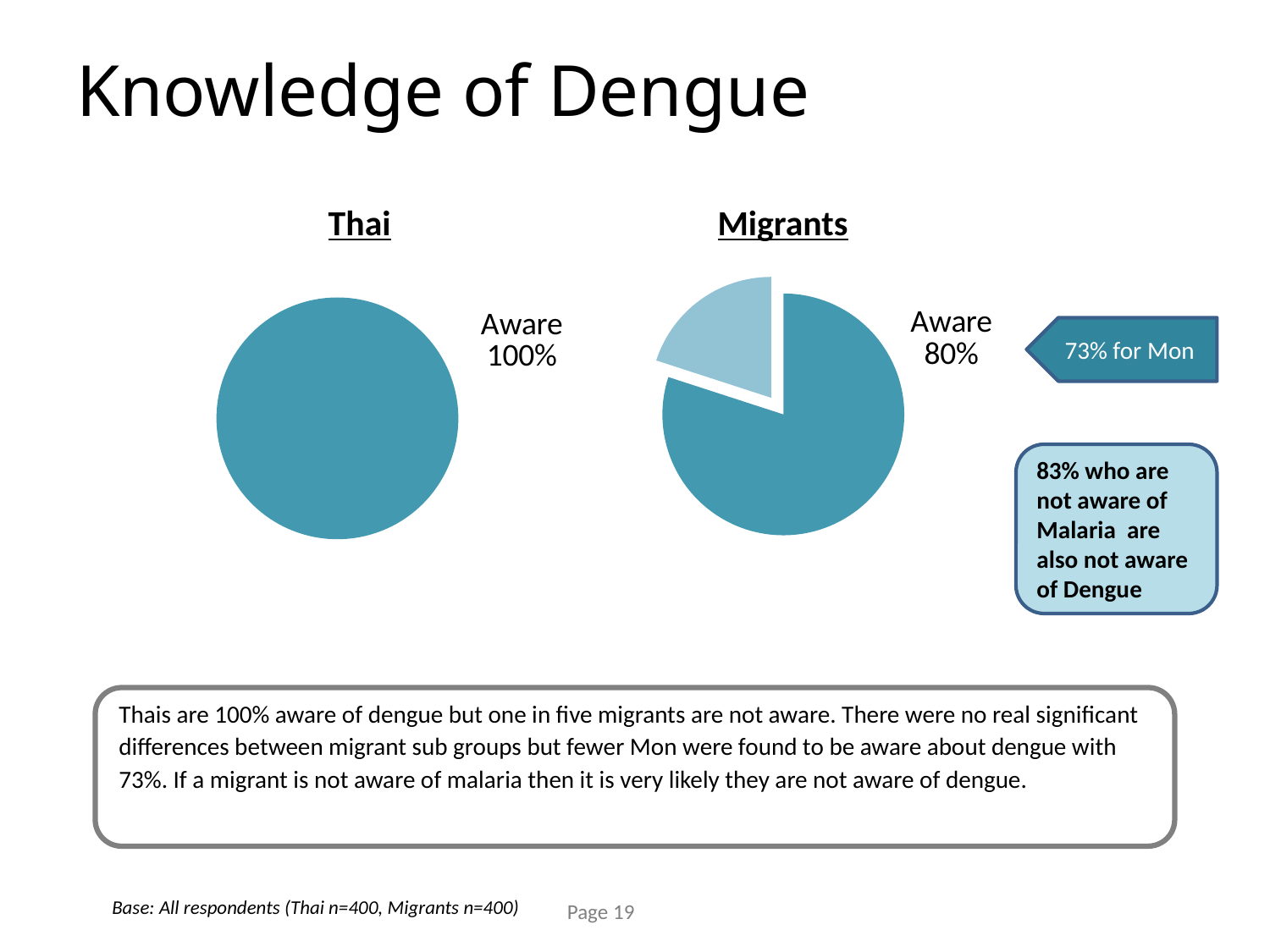
What is the title of the slide containing the two pie charts? Knowledge of Dengue In the Thai pie chart, what percentage are aware of dengue? 100% How many slices does the Thai pie chart have? 1 What kind of chart is used to show awareness for Thai and Migrants? Pie chart What percentage does the callout next to the Migrants pie chart give for Mon? 73% In the Migrants pie chart, what share of the pie does the Aware slice take? 80% What is the difference in percentage points between the Thai aware share and the Migrants aware share? 20 percentage points In the Migrants pie chart, what percentage are aware of dengue? 80% Is the Aware share in the Migrants pie chart greater or less than 50%? greater Which group has the higher share aware of dengue, Thai or Migrants? Thai Which pie chart shows a smaller Aware share, Thai or Migrants? Migrants How many slices does the Migrants pie chart have? 2